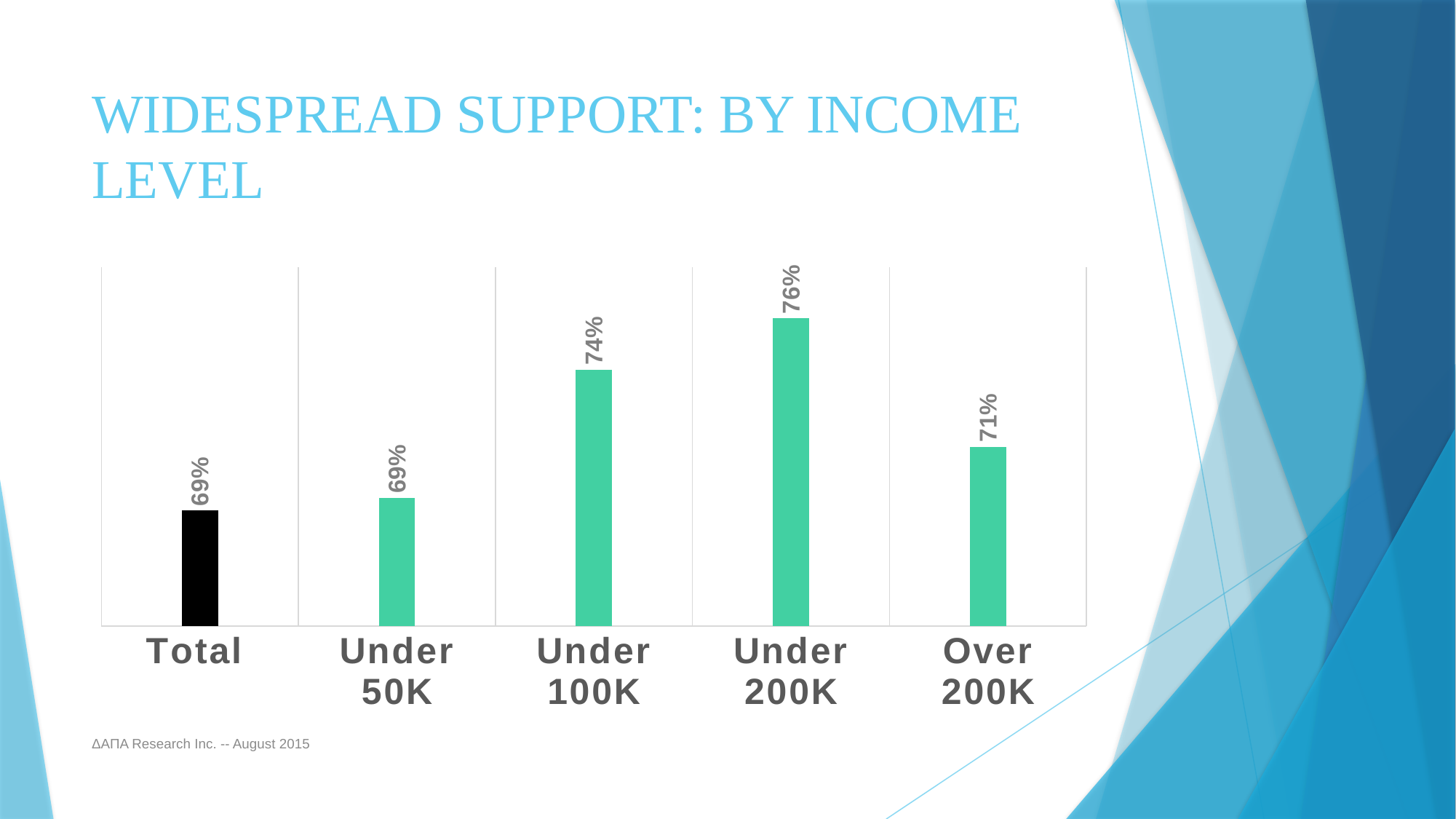
Which bar is coloured black rather than green? Total What is the value for Under 100K? 74% How many categories are shown on the x axis? 5 Which is larger, the value for Under 100K or the value for Over 200K? Under 100K What kind of chart is shown on the slide? Bar chart Which category has the highest value? Under 200K What is the value for Total? 69% What is the value for Over 200K? 71% What is the difference between the values for Under 200K and Under 50K? 7% What is the value for Under 200K? 76% What is the difference between the values for Under 100K and Over 200K? 3% What is the title of the slide containing the chart? WIDESPREAD SUPPORT: BY INCOME LEVEL